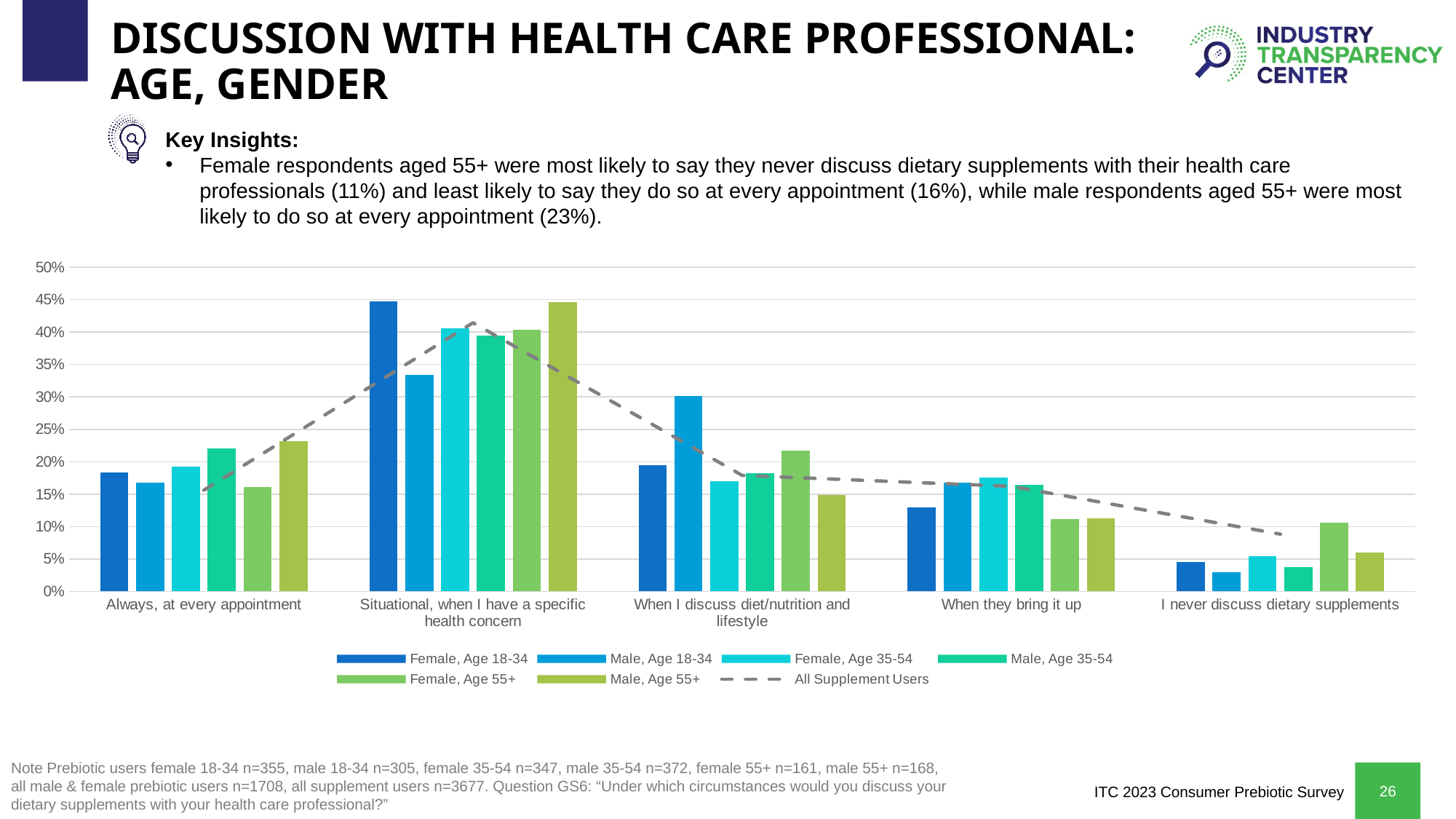
Which category has the shortest bars overall in the chart? I never discuss dietary supplements Is the value for Male, Age 18-34 in the 'Situational, when I have a specific health concern' category greater or less than 35%? less In the 'Always, at every appointment' category, which series has the highest bar? Male, Age 55+ Which category has the tallest bars overall in the chart? Situational, when I have a specific health concern Which series is drawn as a dashed line in the chart? All Supplement Users In the 'When I discuss diet/nutrition and lifestyle' category, which series has the highest bar? Male, Age 18-34 How many series does the chart's legend list? 7 How many categories are shown along the x axis of the chart? 5 In the 'I never discuss dietary supplements' category, which is larger: Female, Age 55+ or Male, Age 55+? Female, Age 55+ Is the value for Female, Age 18-34 in the 'Situational, when I have a specific health concern' category greater or less than 40%? greater What kind of chart is shown on the slide? combination bar and line chart